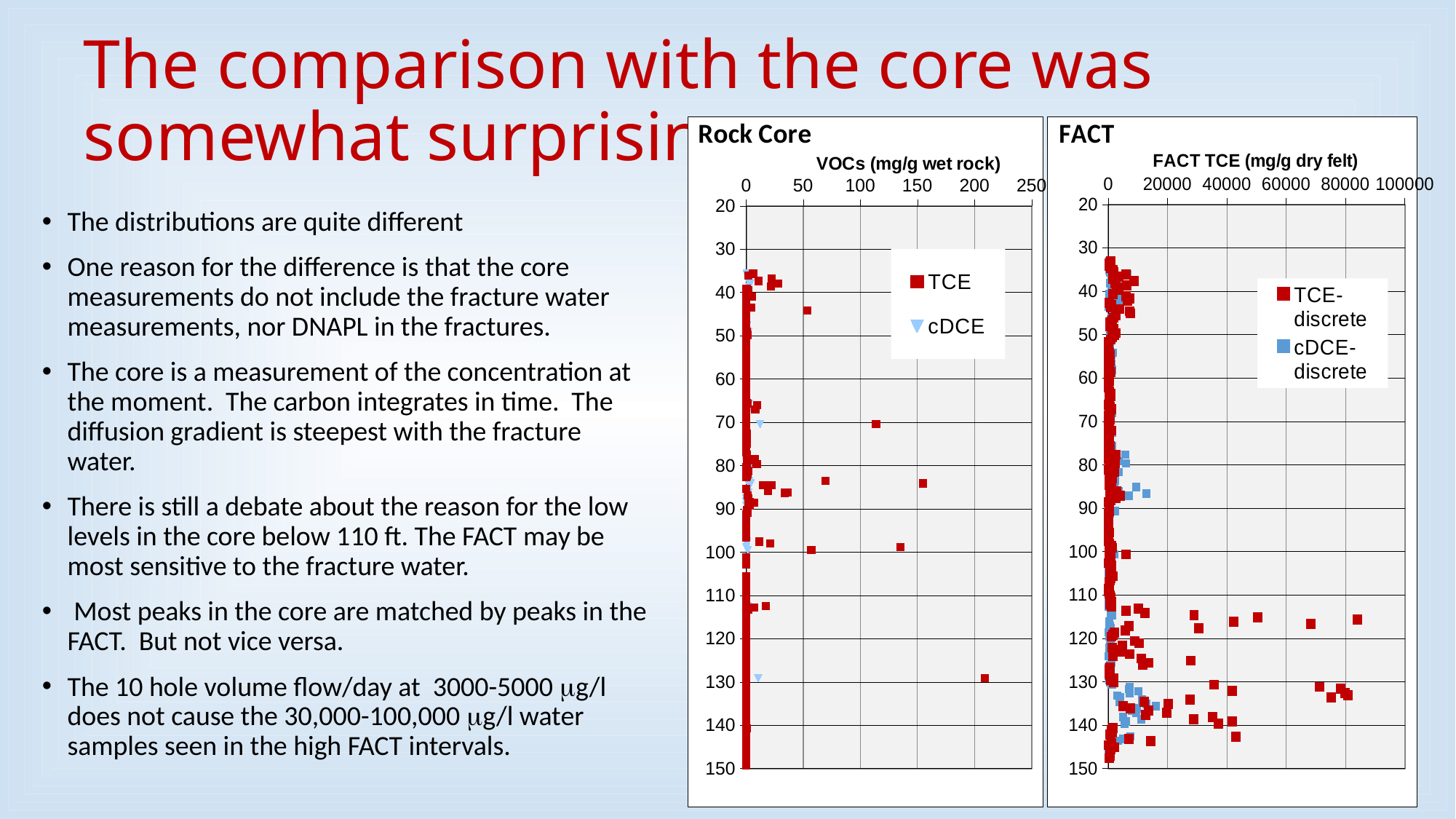
In the Rock Core chart, is the VOC value of the TCE point at a depth of about 70 greater or less than 100? greater In the Rock Core chart, is the VOC value of the TCE point at a depth of about 130 greater or less than 200? greater In the Rock Core chart, which series contains the point with the largest VOC value? TCE What is the x-axis title of the Rock Core chart? VOCs (mg/g wet rock) In the FACT chart, is the largest TCE-discrete value (at a depth of about 115) greater or less than 80000? greater How many series does the legend of the Rock Core chart list? 2 How many series does the legend of the FACT chart list? 2 In the FACT chart, which series contains the point with the largest value on the x axis? TCE-discrete What kind of chart is the Rock Core chart? scatter chart What kind of chart is the FACT chart? scatter chart What are the two series named in the legend of the FACT chart? TCE-discrete and cDCE-discrete